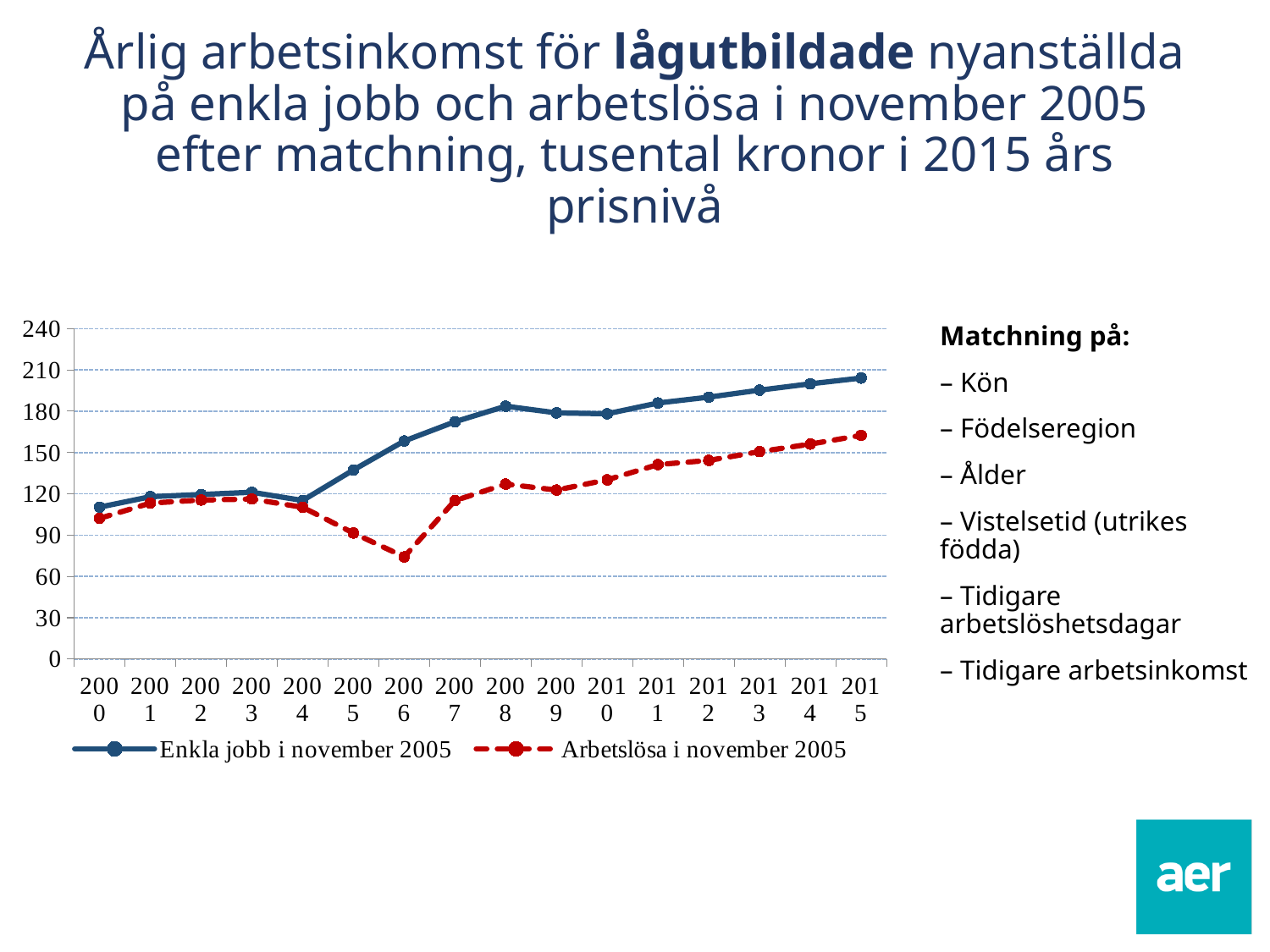
Is the value for Arbetslösa i november 2005 in 2006 greater or less than 90? less Is the value for Arbetslösa i november 2005 in 2015 greater or less than 150? greater Do the values for Arbetslösa i november 2005 rise or fall from 2010 to 2015? rise How many years are plotted along the x axis? 16 How many series does the legend list? 2 In which year is the value for Arbetslösa i november 2005 highest? 2015 In which year is the value for Arbetslösa i november 2005 lowest? 2006 In 2010, which series has the larger value: Enkla jobb i november 2005 or Arbetslösa i november 2005? Enkla jobb i november 2005 Is the value for Enkla jobb i november 2005 in 2015 greater or less than 180? greater In which year is the value for Enkla jobb i november 2005 highest? 2015 Which series is drawn with a red dashed line? Arbetslösa i november 2005 What kind of chart is shown on the slide? line chart